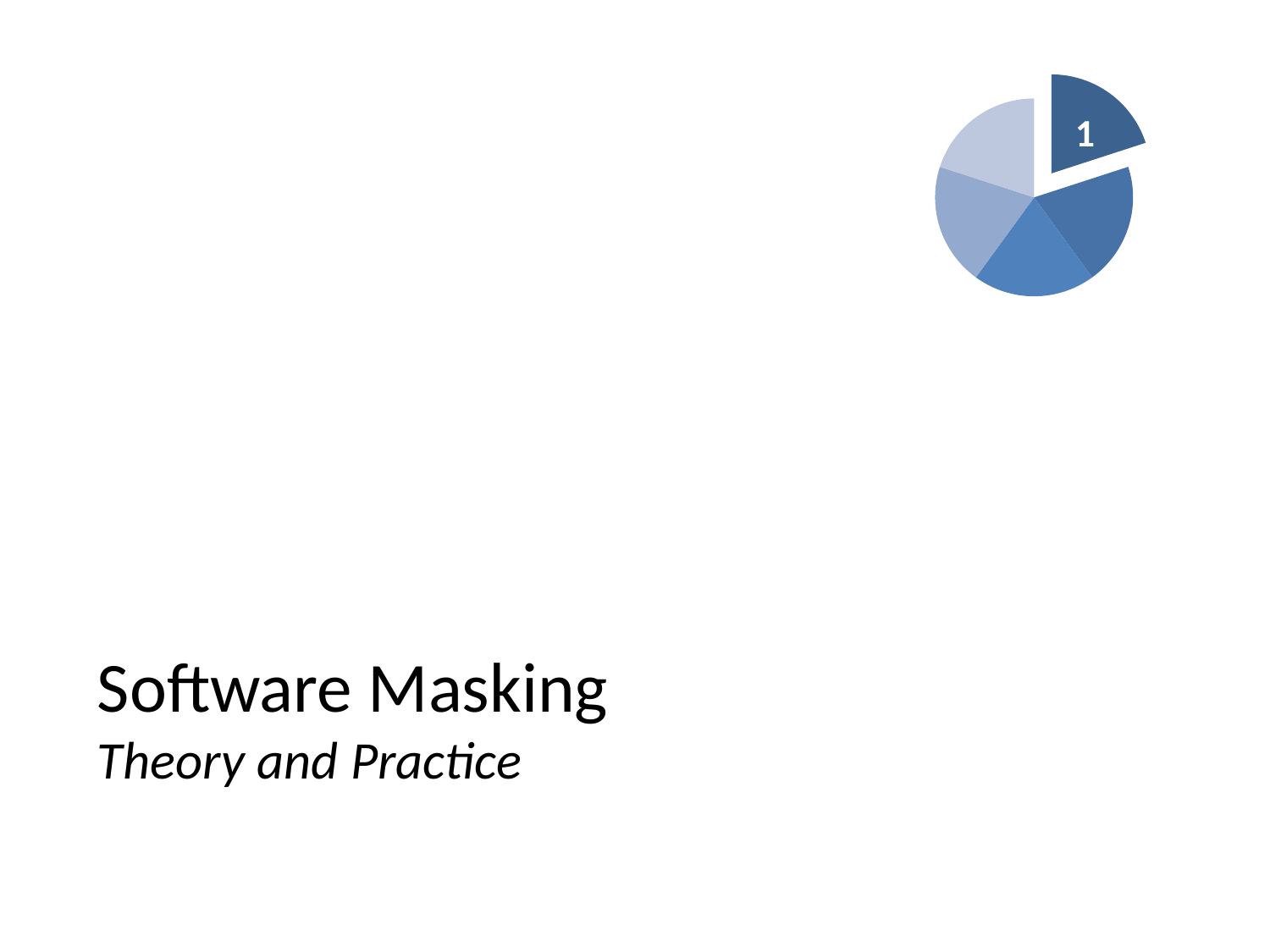
Does the pie chart have a legend? no What label is printed on the slice that is pulled out from the pie chart? 1 How many slices does the pie chart have? 5 What kind of chart is shown on the slide? pie chart Is the slice labelled 1 separated (exploded) from the rest of the pie? yes How many slices of the pie chart carry a printed label? 1